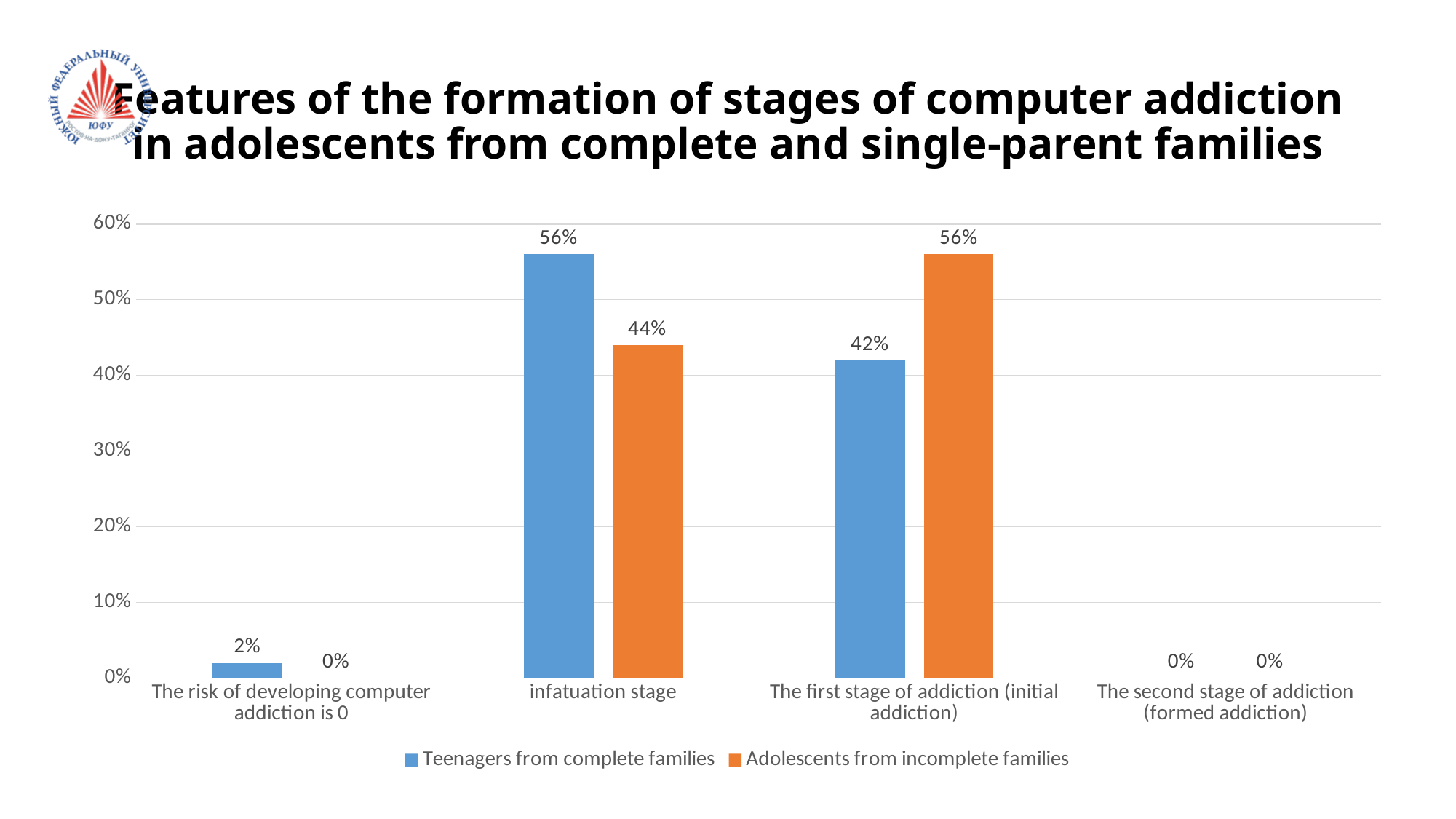
At the first stage of addiction (initial addiction), which series has the larger value? Adolescents from incomplete families How many categories are shown on the x axis? 4 What is the difference between the two series at the infatuation stage? 12% What is the value for Adolescents from incomplete families at the infatuation stage? 44% How many series does the legend list? 2 What is the value for Teenagers from complete families at the first stage of addiction (initial addiction)? 42% What is the value for Teenagers from complete families at the infatuation stage? 56% What kind of chart is shown on the slide? Bar chart What is the difference between the two series at the first stage of addiction (initial addiction)? 14% What is the value for Teenagers from complete families in the category 'The risk of developing computer addiction is 0'? 2% What is the value for Adolescents from incomplete families at the first stage of addiction (initial addiction)? 56% Which category has the highest value for Adolescents from incomplete families? The first stage of addiction (initial addiction)